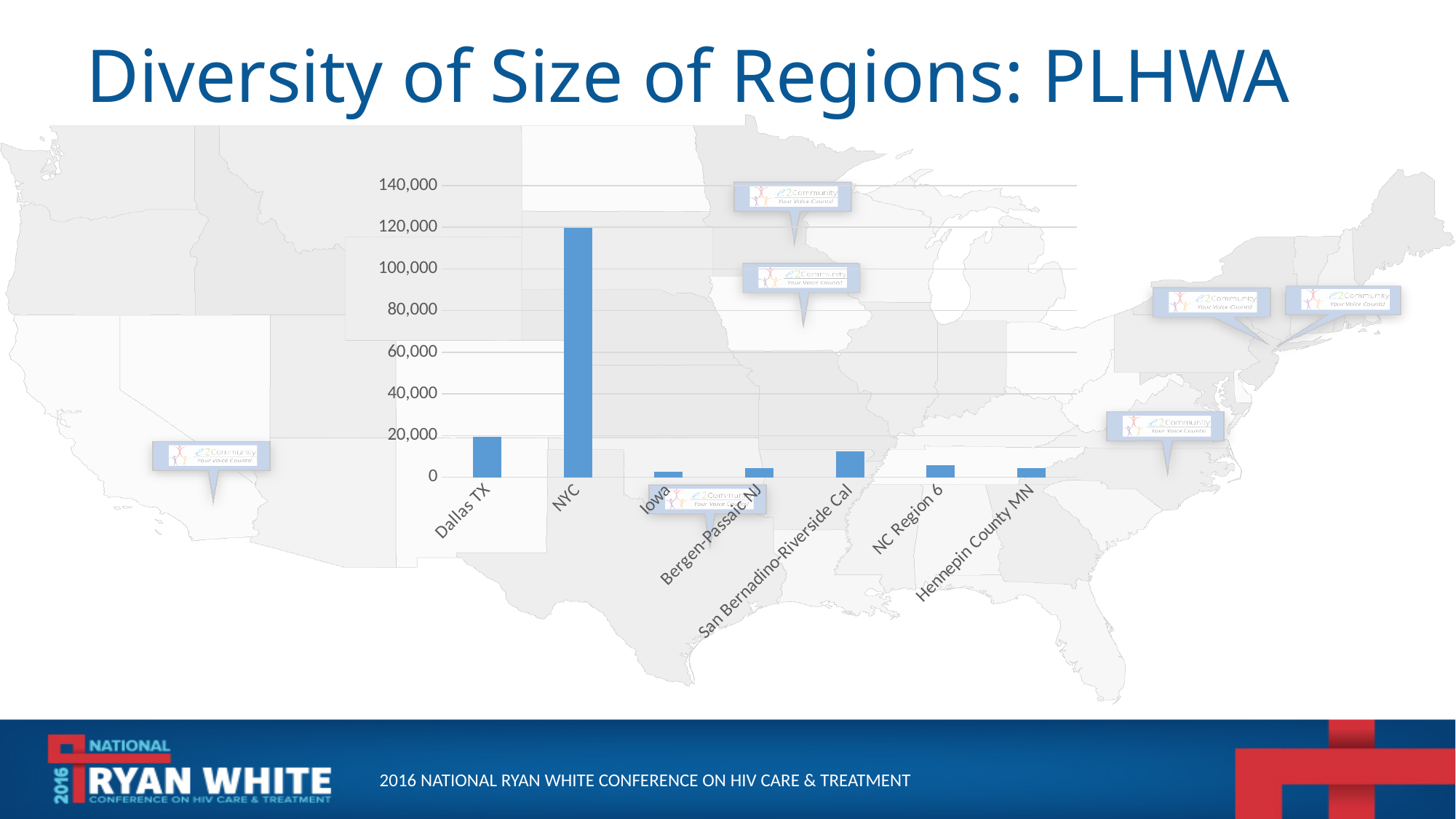
Is the value for NYC greater or less than 140,000? less What kind of chart is shown on the slide? bar chart Is the value for NYC greater or less than 100,000? greater Which region has the highest value on the chart? NYC Which is larger, the value for Dallas TX or the value for San Bernadino-Riverside Cal? Dallas TX Is the value for Dallas TX greater or less than 40,000? less How many regions are plotted on the chart? 7 Which is larger, the value for NC Region 6 or the value for Iowa? NC Region 6 Which region has the lowest value on the chart? Iowa What is the highest value shown on the chart's vertical axis? 140,000 What is the title of the slide containing the chart? Diversity of Size of Regions: PLHWA